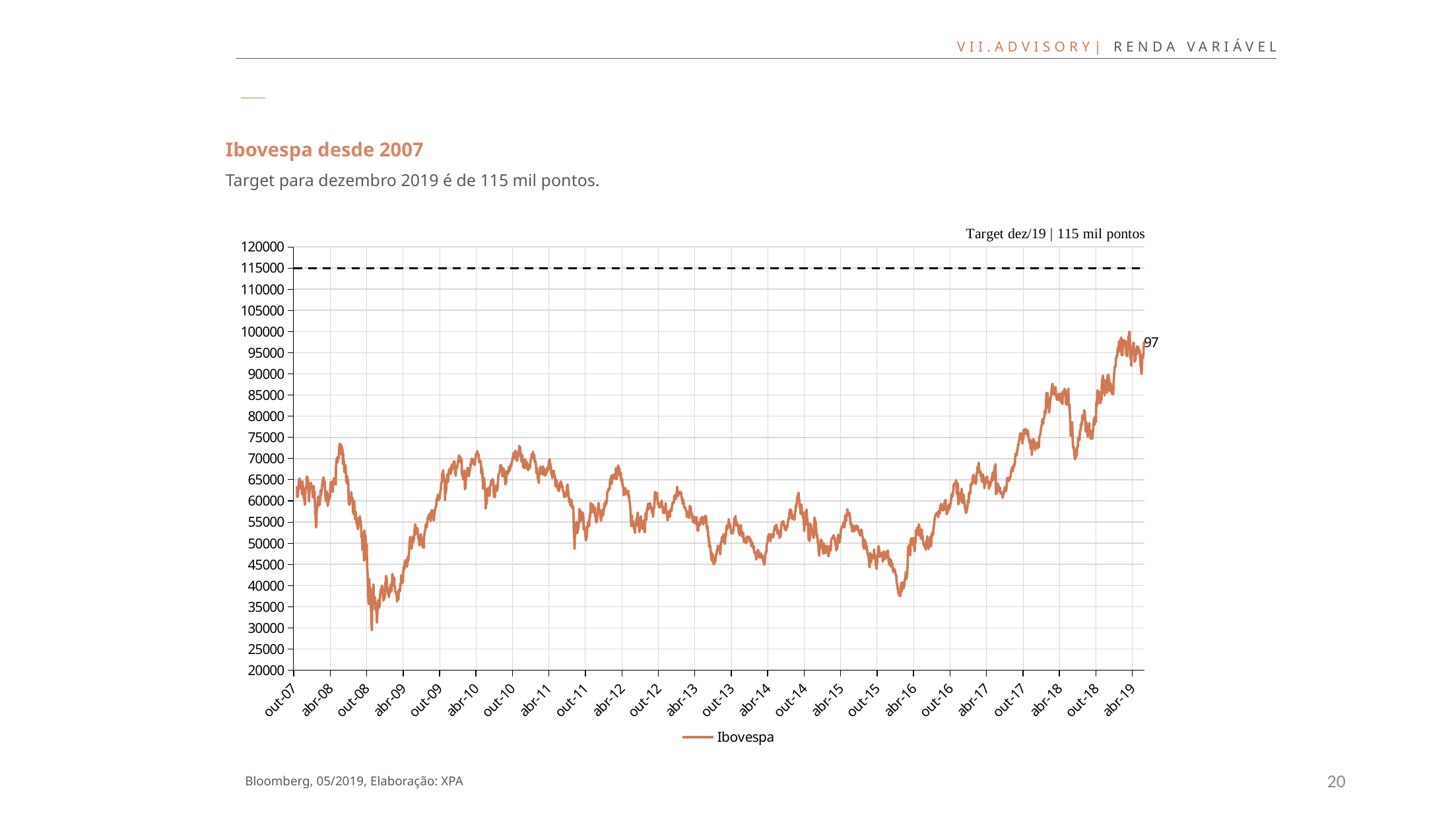
How many series does the legend list? 1 Is the lowest value reached by the Ibovespa line greater or less than 35000? less What is the title of the chart? Ibovespa desde 2007 What kind of chart is shown on the slide? line chart Which is higher: the Ibovespa value at abr-19 or at out-07? abr-19 How many date labels are shown on the x axis? 24 Overall, does the Ibovespa line rise or fall from out-07 to abr-19? rise What value does the dashed target line for dez/19 represent? 115 mil pontos Is the Ibovespa value at out-07 greater or less than 55000? greater Is the Ibovespa value at abr-18 greater or less than 80000? greater What is the data label shown at the end of the Ibovespa line? 97